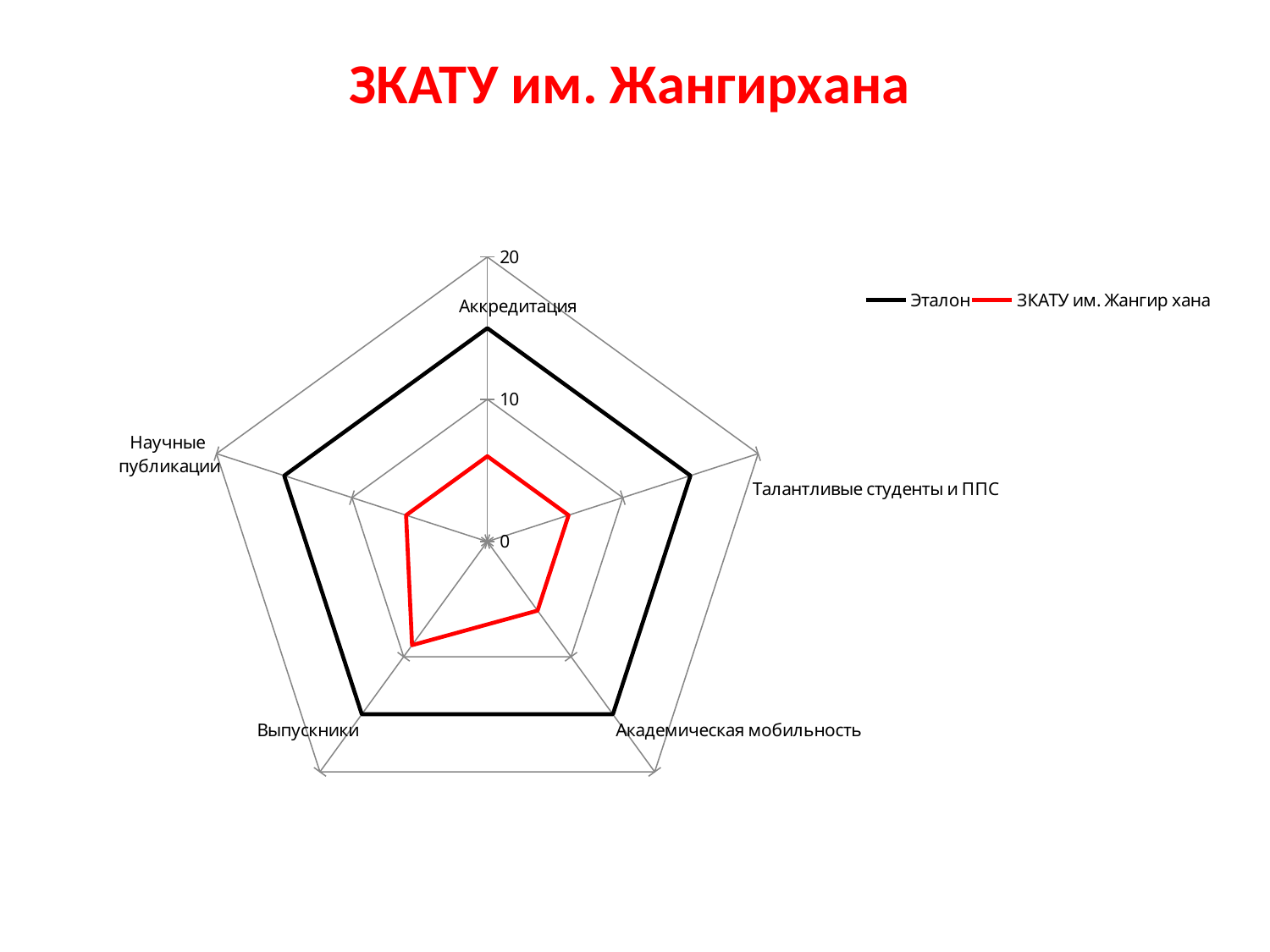
How many categories (axes) does the radar chart have? 5 For Научные публикации, which series has the larger value, Эталон or ЗКАТУ им. Жангир хана? Эталон Is the value of Эталон for Академическая мобильность greater or less than 20? less For which category does ЗКАТУ им. Жангир хана have its highest value? Выпускники Which series is drawn with the red line? ЗКАТУ им. Жангир хана How many series does the legend list? 2 Is the value of Эталон for Аккредитация greater or less than 10? greater What kind of chart is shown on the slide? radar chart What colour is the line for the Эталон series? black Is the value of ЗКАТУ им. Жангир хана for Аккредитация greater or less than 10? less For ЗКАТУ им. Жангир хана, which is larger: the value for Выпускники or the value for Аккредитация? Выпускники